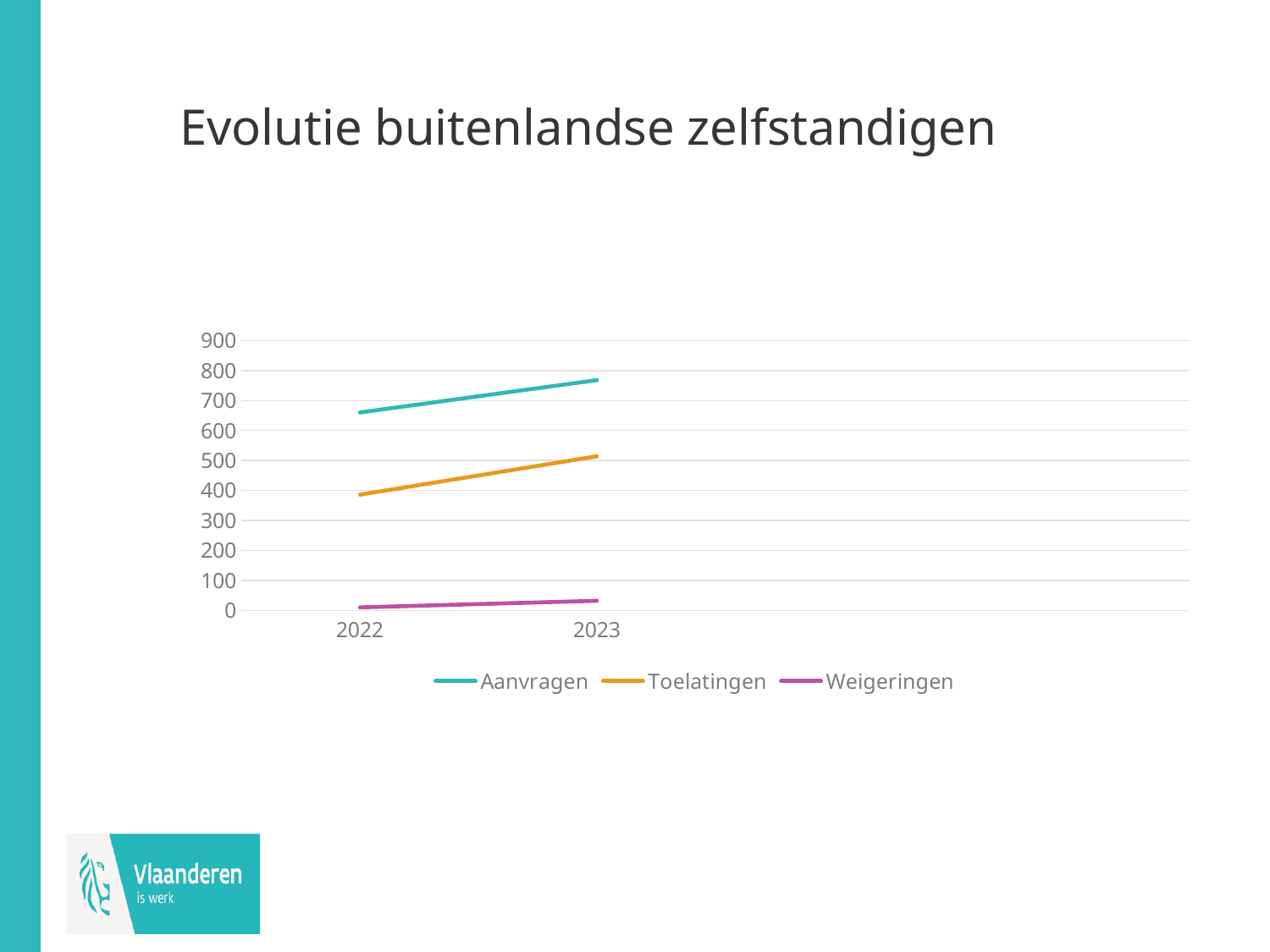
Is the value for Aanvragen in 2022 greater or less than 600? greater In 2023, which is larger: Aanvragen or Toelatingen? Aanvragen Does the Aanvragen line rise or fall from 2022 to 2023? rise How many series does the legend list? 3 What kind of chart is shown on the slide? line chart What is the title of the chart on the slide? Evolutie buitenlandse zelfstandigen Does the Toelatingen line rise or fall from 2022 to 2023? rise How many years are shown on the x axis? 2 Which series has the highest values in the chart? Aanvragen Which series has the lowest values in the chart? Weigeringen Is the value for Weigeringen in 2023 greater or less than 100? less Is the value for Aanvragen in 2023 greater or less than 700? greater